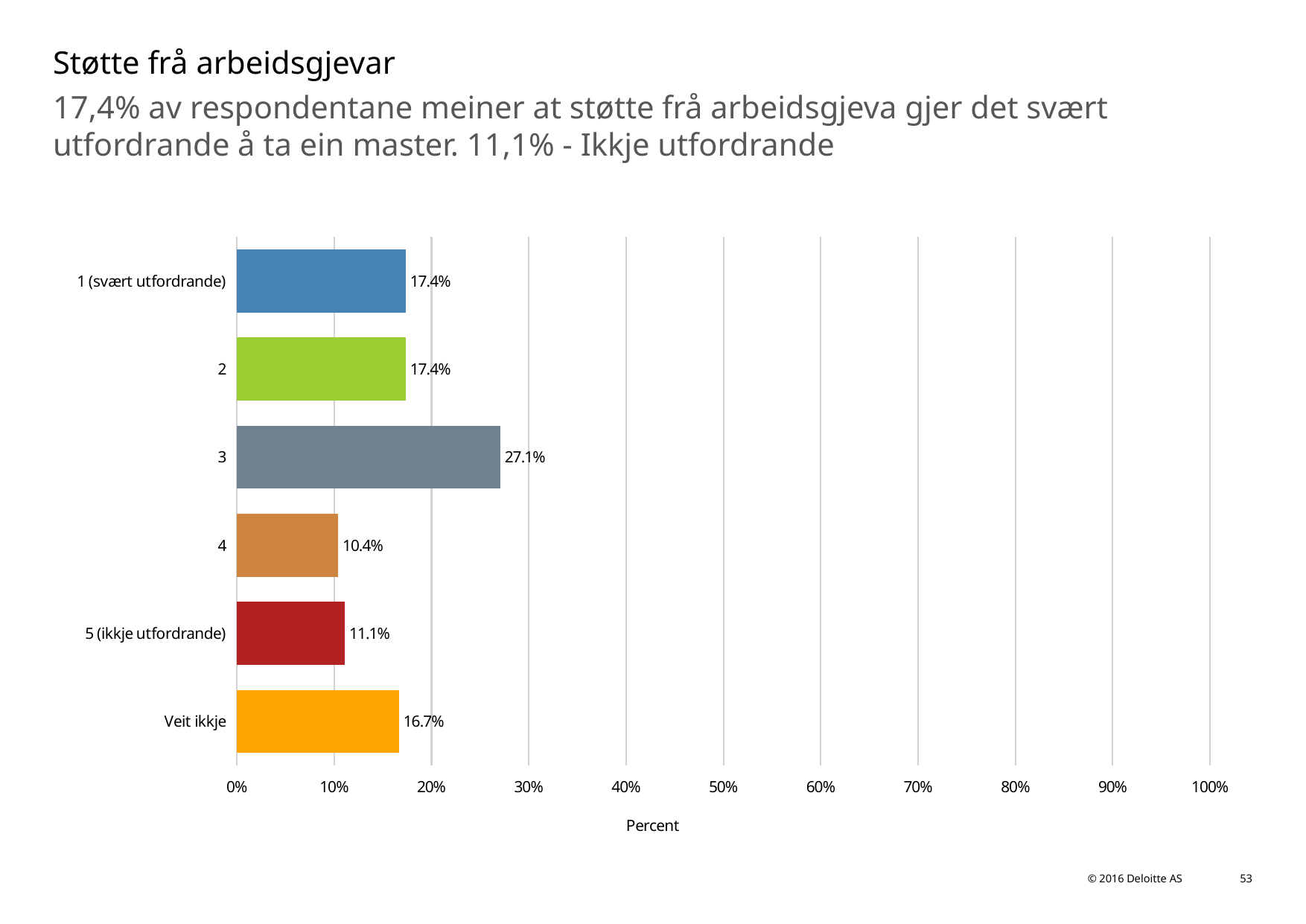
How many categories are shown in the chart? 6 Is the value for category 3 greater or less than 20%? greater What is the difference between the values for category 3 and category 4? 16.7% What is the value for category 3? 27.1% What is the value for category 4? 10.4% Which category has the lowest value? 4 What is the value for '5 (ikkje utfordrande)'? 11.1% What kind of chart is shown on the slide? bar chart What is the value for 'Veit ikkje'? 16.7% What is the label of the horizontal axis? Percent Which is larger, the value for 'Veit ikkje' or the value for '5 (ikkje utfordrande)'? Veit ikkje Which category has the highest value? 3